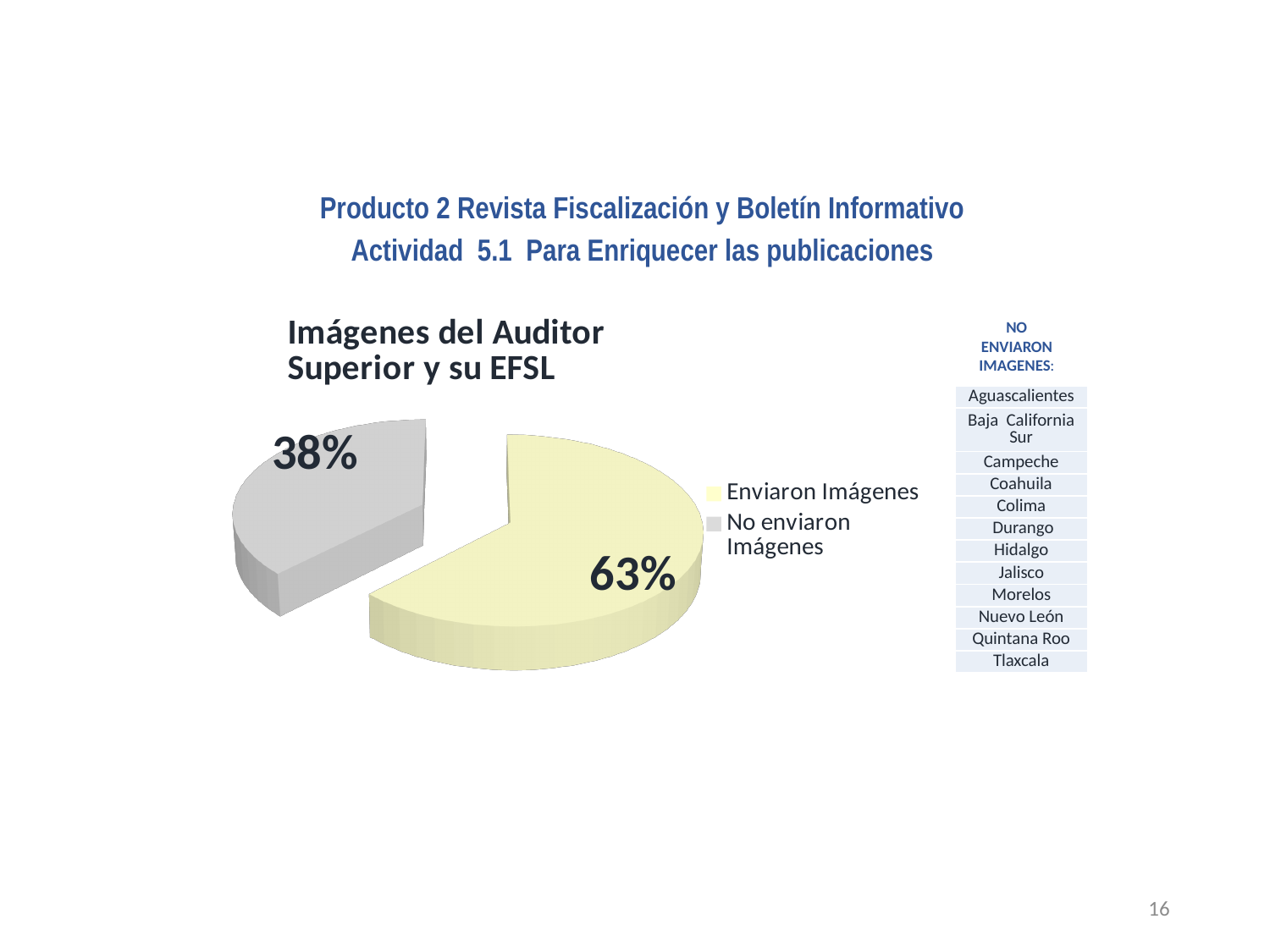
Which slice is the largest? Enviaron Imágenes Which is larger, the "Enviaron Imágenes" slice or the "No enviaron Imágenes" slice? Enviaron Imágenes What kind of chart is shown on the slide? pie chart What is the title of the chart? Imágenes del Auditor Superior y su EFSL What colour is the "No enviaron Imágenes" slice? grey What is the difference in percentage points between the "Enviaron Imágenes" slice and the "No enviaron Imágenes" slice? 25 How many entries does the legend list? 2 How many slices does the pie chart have? 2 What share of the pie is labelled "Enviaron Imágenes"? 63% Which slice is the smallest? No enviaron Imágenes What share of the pie is labelled "No enviaron Imágenes"? 38%